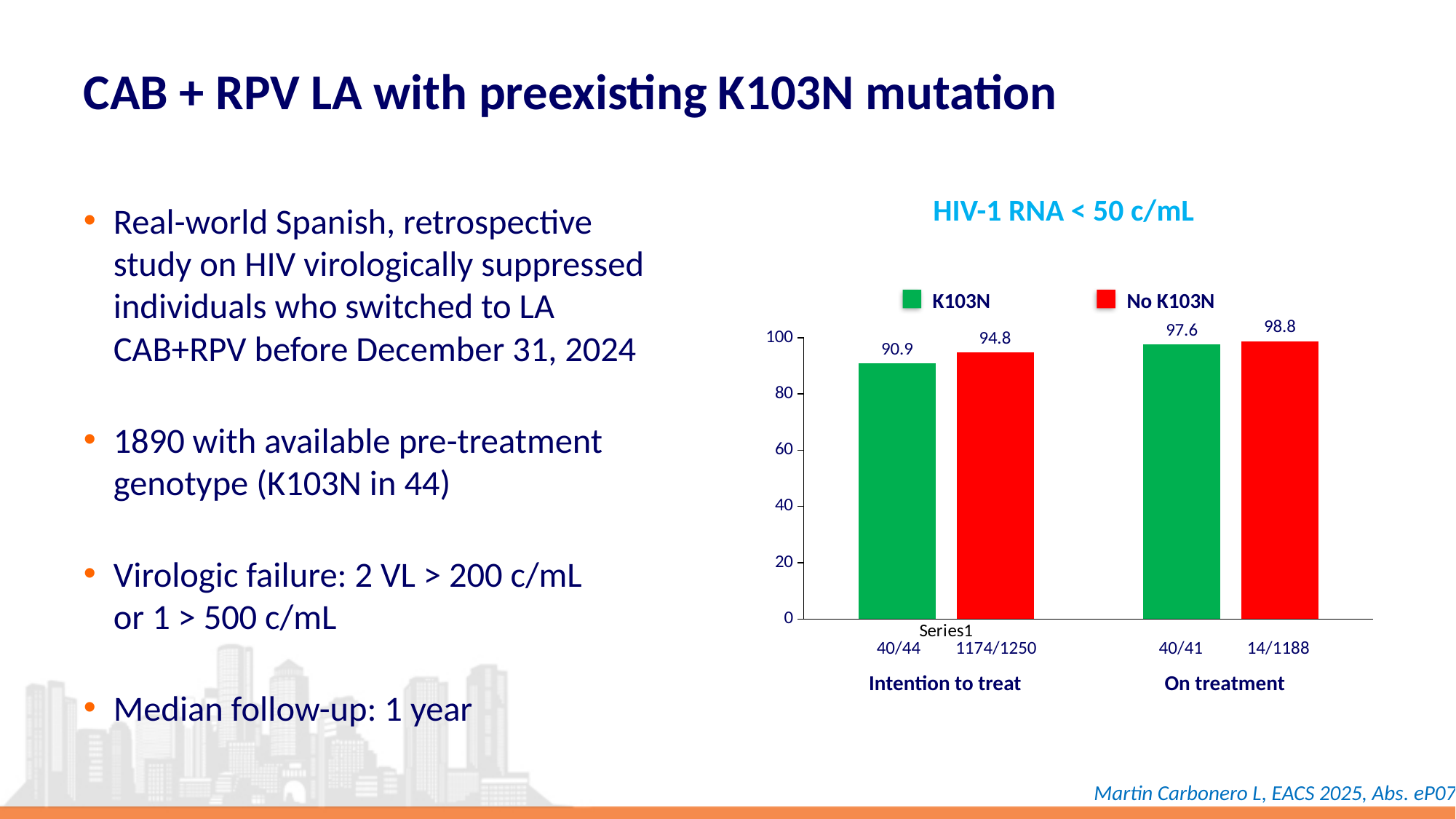
What is the value for No K103N in the Intention to treat group? 94.8 What is the title of the chart? HIV-1 RNA < 50 c/mL What is the difference between the No K103N and K103N values in the On treatment group? 1.2 What is the difference between the No K103N and K103N values in the Intention to treat group? 3.9 What is the value for No K103N in the On treatment group? 98.8 Which bar has the lowest value on the chart? K103N, Intention to treat Which bar has the highest value on the chart? No K103N, On treatment What kind of chart is shown on the slide? Bar chart What is the value for K103N in the Intention to treat group? 90.9 How many series does the legend list? 2 What is the value for K103N in the On treatment group? 97.6 Which is larger in the Intention to treat group, K103N or No K103N? No K103N